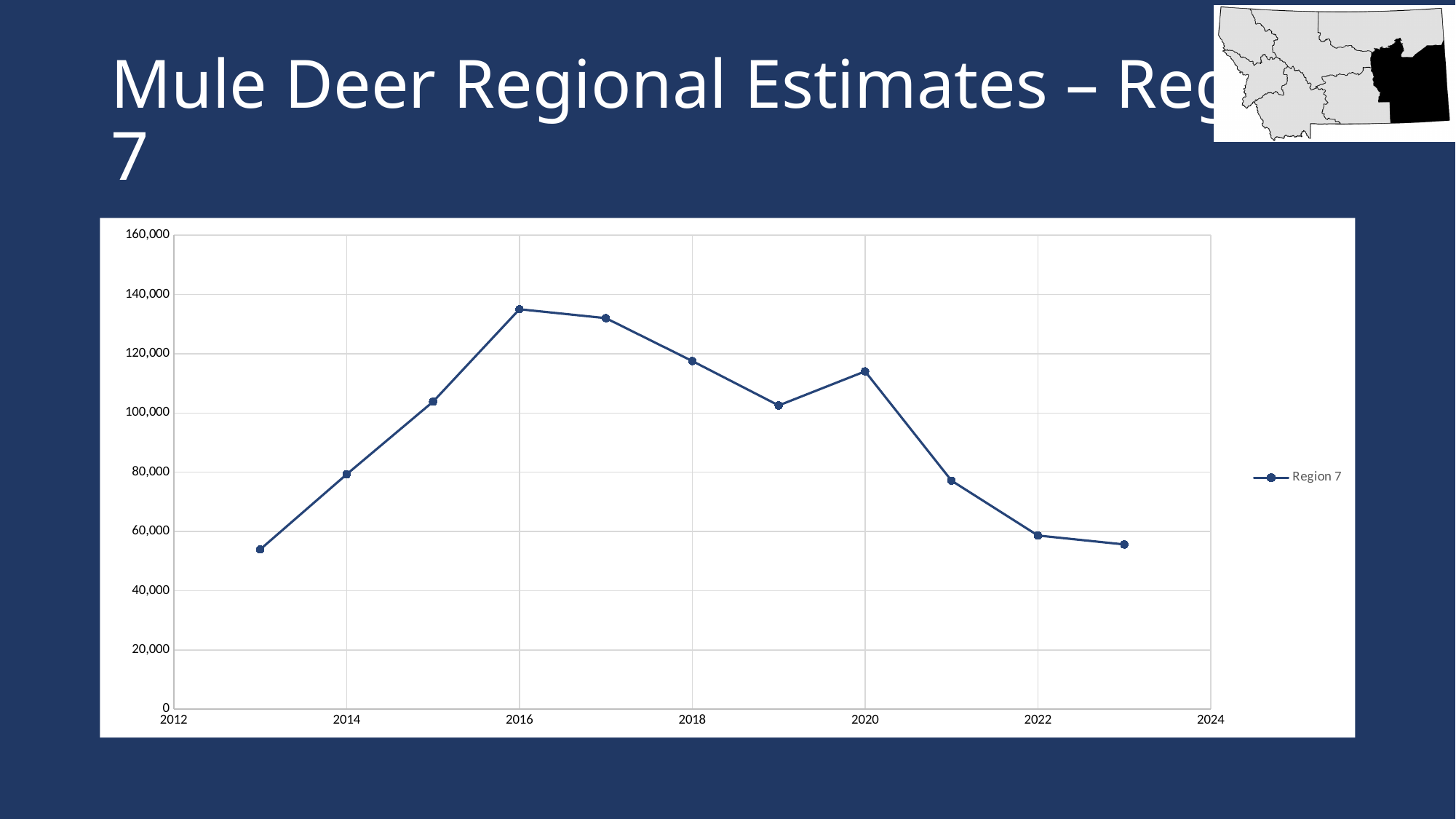
Is the value for 2013 greater or less than 60,000? less In which year is the Region 7 estimate highest? 2016 Is the value for 2021 greater or less than 80,000? less Is the value for 2019 greater or less than 100,000? greater Which year has the larger value, 2014 or 2022? 2014 What is the name of the series shown in the legend? Region 7 How many data points are plotted on the line? 11 Which year has the larger value, 2016 or 2020? 2016 How many series does the legend list? 1 Do the values rise or fall from 2020 to 2023? fall What kind of chart is shown on the slide? line chart